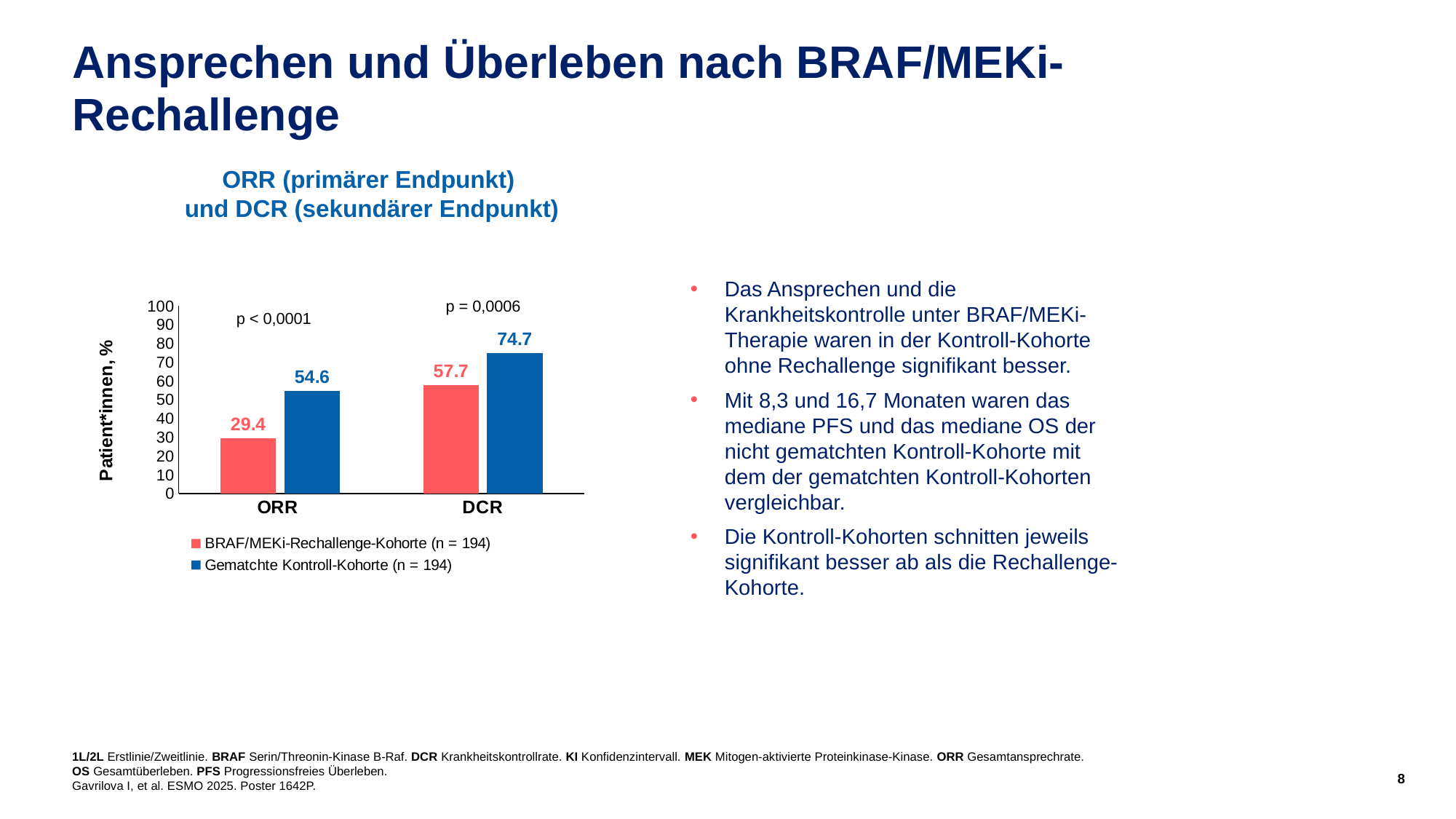
What is the difference between the ORR values of the Gematchte Kontroll-Kohorte and the BRAF/MEKi-Rechallenge-Kohorte? 25.2 What kind of chart is shown on the slide? Bar chart What is the ORR value for the Gematchte Kontroll-Kohorte (n = 194)? 54.6 Which bar in the chart has the highest value? DCR, Gematchte Kontroll-Kohorte (n = 194) How many categories are shown on the x axis of the chart? 2 What is the DCR value for the Gematchte Kontroll-Kohorte (n = 194)? 74.7 What is the ORR value for the BRAF/MEKi-Rechallenge-Kohorte (n = 194)? 29.4 For DCR, which cohort has the larger value? Gematchte Kontroll-Kohorte (n = 194) Which bar in the chart has the lowest value? ORR, BRAF/MEKi-Rechallenge-Kohorte (n = 194) What is the DCR value for the BRAF/MEKi-Rechallenge-Kohorte (n = 194)? 57.7 How many series does the chart legend list? 2 What is the difference between the DCR values of the Gematchte Kontroll-Kohorte and the BRAF/MEKi-Rechallenge-Kohorte? 17